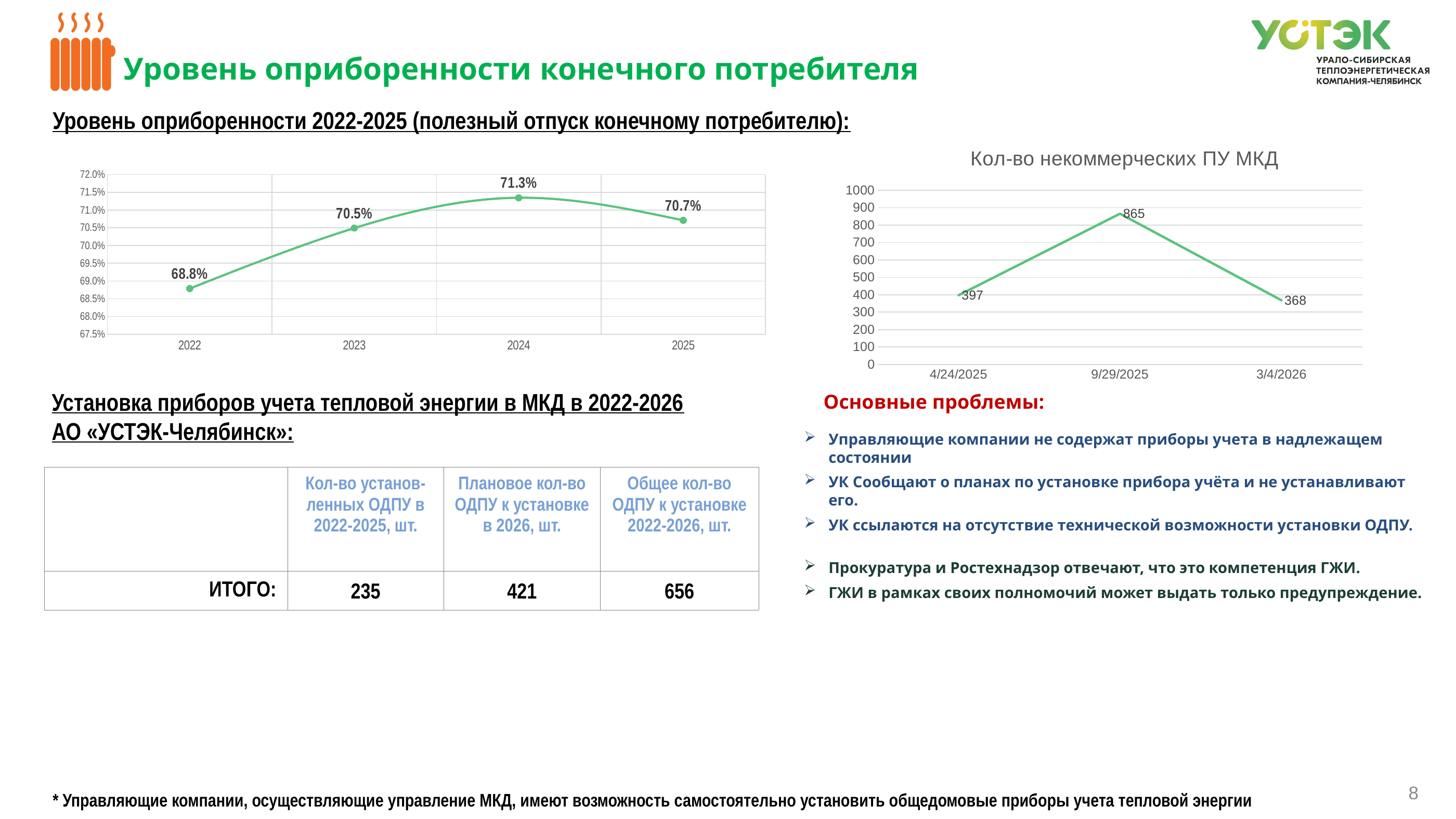
In the left chart (Уровень оприборенности 2022-2025), what is the difference between the 2023 and 2022 values? 1.7% In the chart titled 'Кол-во некоммерческих ПУ МКД', what is the value for 9/29/2025? 865 In the chart titled 'Кол-во некоммерческих ПУ МКД', which date has the lowest value? 3/4/2026 In the chart titled 'Кол-во некоммерческих ПУ МКД', what is the value for 3/4/2026? 368 In the chart titled 'Кол-во некоммерческих ПУ МКД', is the value for 4/24/2025 larger than the value for 3/4/2026? Yes In the left chart (Уровень оприборенности 2022-2025), what is the value for 2024? 71.3% In the left chart (Уровень оприборенности 2022-2025), which year has the lowest value? 2022 In the left chart (Уровень оприборенности 2022-2025), how many years are plotted? 4 In the chart titled 'Кол-во некоммерческих ПУ МКД', what is the difference between the values for 9/29/2025 and 4/24/2025? 468 In the left chart (Уровень оприборенности 2022-2025), which year has the highest value? 2024 In the left chart (Уровень оприборенности 2022-2025), what is the value for 2022? 68.8% In the left chart (Уровень оприборенности 2022-2025), what kind of chart is it? Line chart